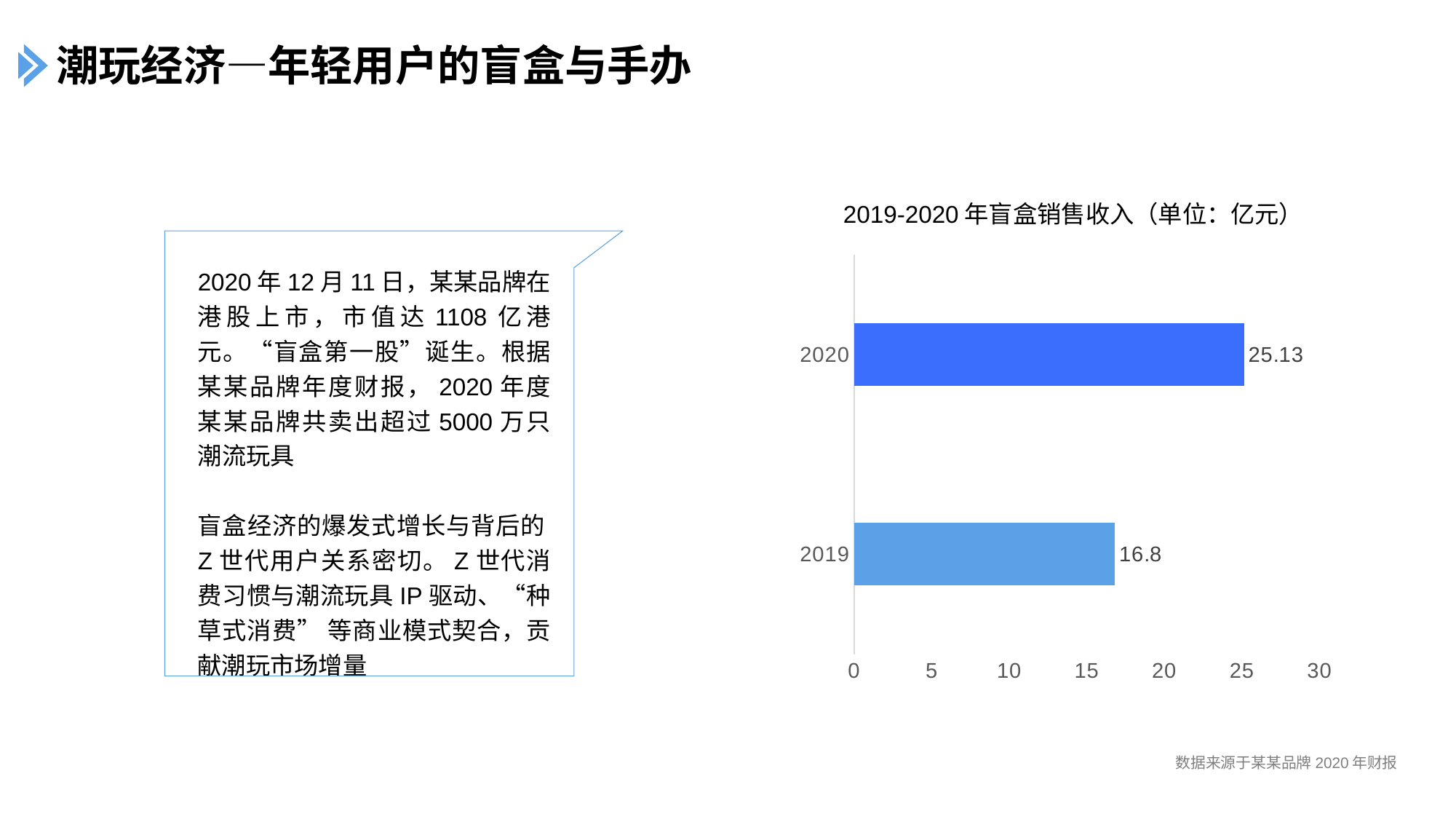
Which is larger, the value for 2020 or the value for 2019? 2020 What is the value for 2020? 25.13 Is the value for 2020 greater or less than 25? greater How many categories are shown in the chart? 2 What is the value for 2019? 16.8 What is the title of the chart? 2019-2020 年盲盒销售收入（单位：亿元） Which year has the highest value? 2020 What kind of chart is shown on the slide? bar chart Do the values rise or fall from 2019 to 2020? rise What is the difference between the values for 2020 and 2019? 8.33 Is the value for 2019 greater or less than 20? less Which year has the lowest value? 2019